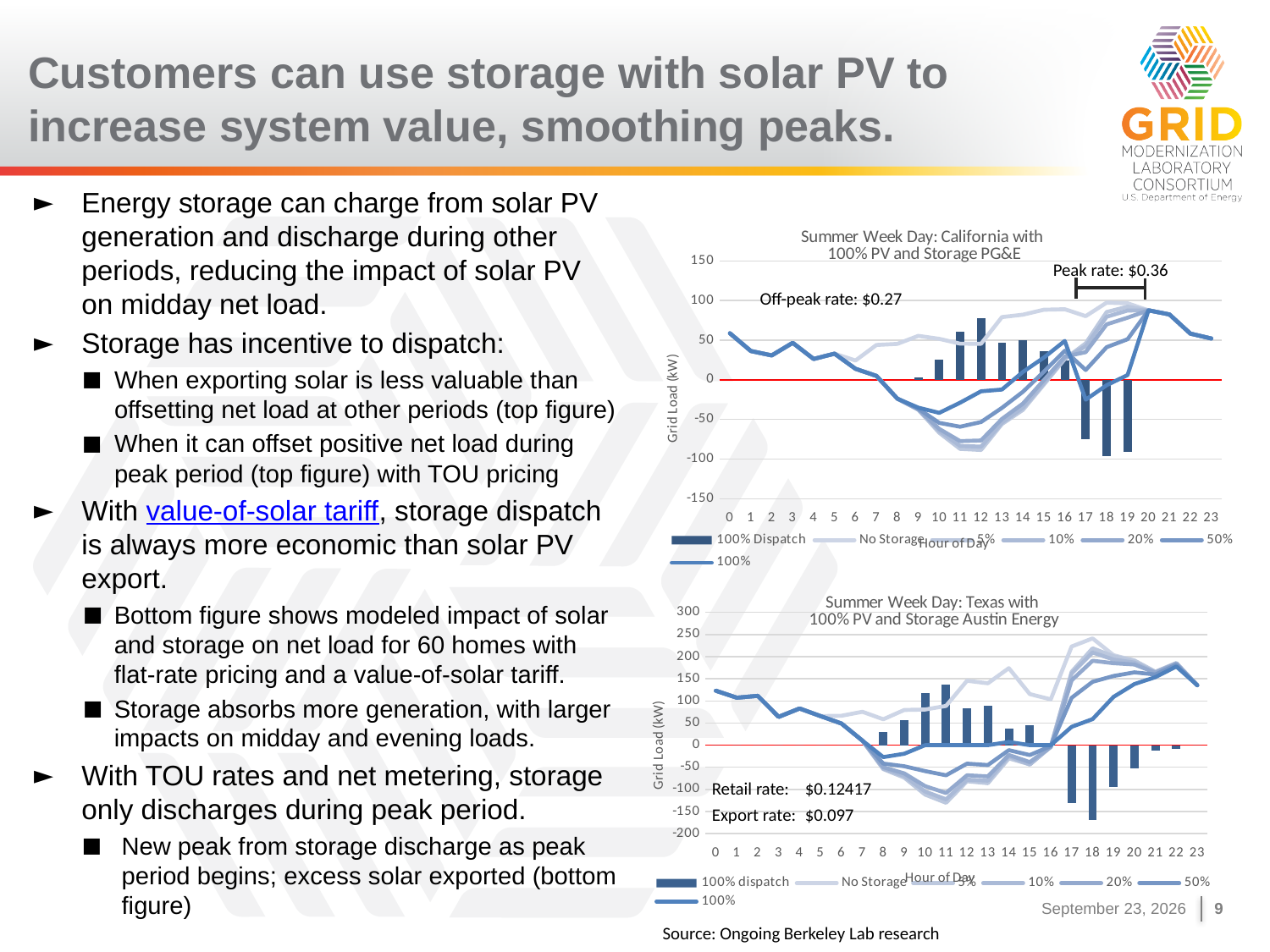
How many hours of the day are plotted along the x axis of the top chart (California)? 24 In the top chart (California), at which hour is the tallest positive 100% Dispatch bar? 12 What is the title of the top chart? Summer Week Day: California with 100% PV and Storage PG&E In the top chart (California), is the 100% Dispatch bar at hour 18 greater or less than -50 kW? less In the bottom chart (Texas), is the 100% dispatch bar at hour 11 greater or less than 100 kW? greater What kind of chart is the bottom chart (Texas)? Combined bar and line chart How many series does the legend of the bottom chart (Texas) list? 7 In the bottom chart (Texas), is the 100% dispatch bar at hour 18 greater or less than -100 kW? less In the bottom chart (Texas), at which hour is the most negative 100% dispatch bar? 18 In the bottom chart (Texas), does the No Storage line rise or fall between hour 16 and hour 19? rise In the top chart (California), what peak rate is annotated? $0.36